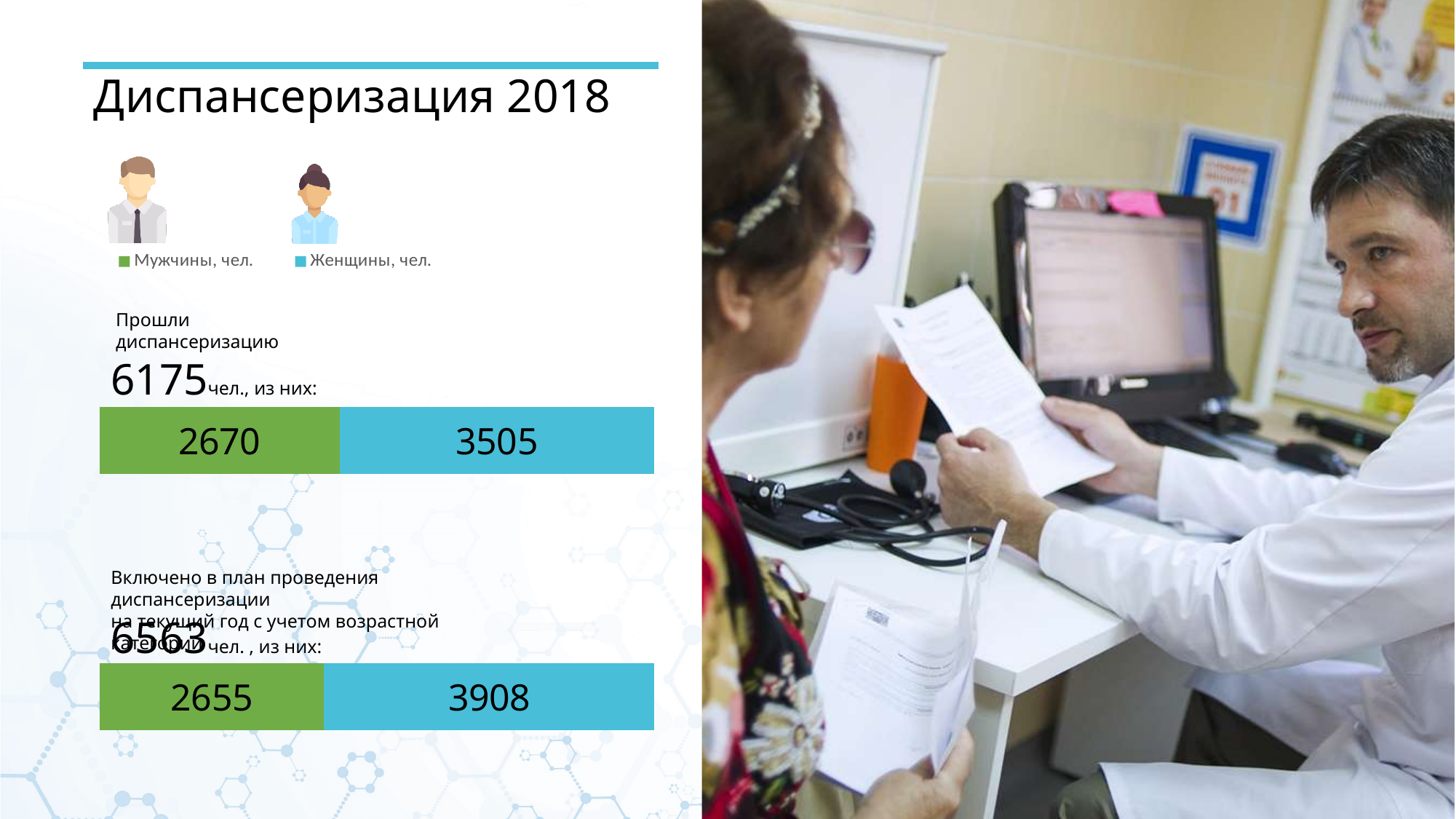
In the lower chart (Включено в план проведения диспансеризации), what is the value for Женщины, чел.? 3908 In the upper chart, what is the difference between the values for Женщины and Мужчины? 835 In the lower chart, which series has the larger value, Мужчины or Женщины? Женщины What is the total of the stacked bar in the lower chart (Включено в план проведения диспансеризации)? 6563 In the lower chart, what is the difference between the values for Женщины and Мужчины? 1253 How many series does the legend list for the charts on this slide? 2 In the lower chart (Включено в план проведения диспансеризации), what is the value for Мужчины, чел.? 2655 What type of chart is used to show the Мужчины and Женщины values on this slide? Stacked bar chart In the upper chart, which series has the larger value, Мужчины or Женщины? Женщины What is the total of the stacked bar in the upper chart (Прошли диспансеризацию)? 6175 In the upper chart (Прошли диспансеризацию), what is the value for Женщины, чел.? 3505 In the upper chart (Прошли диспансеризацию), what is the value for Мужчины, чел.? 2670